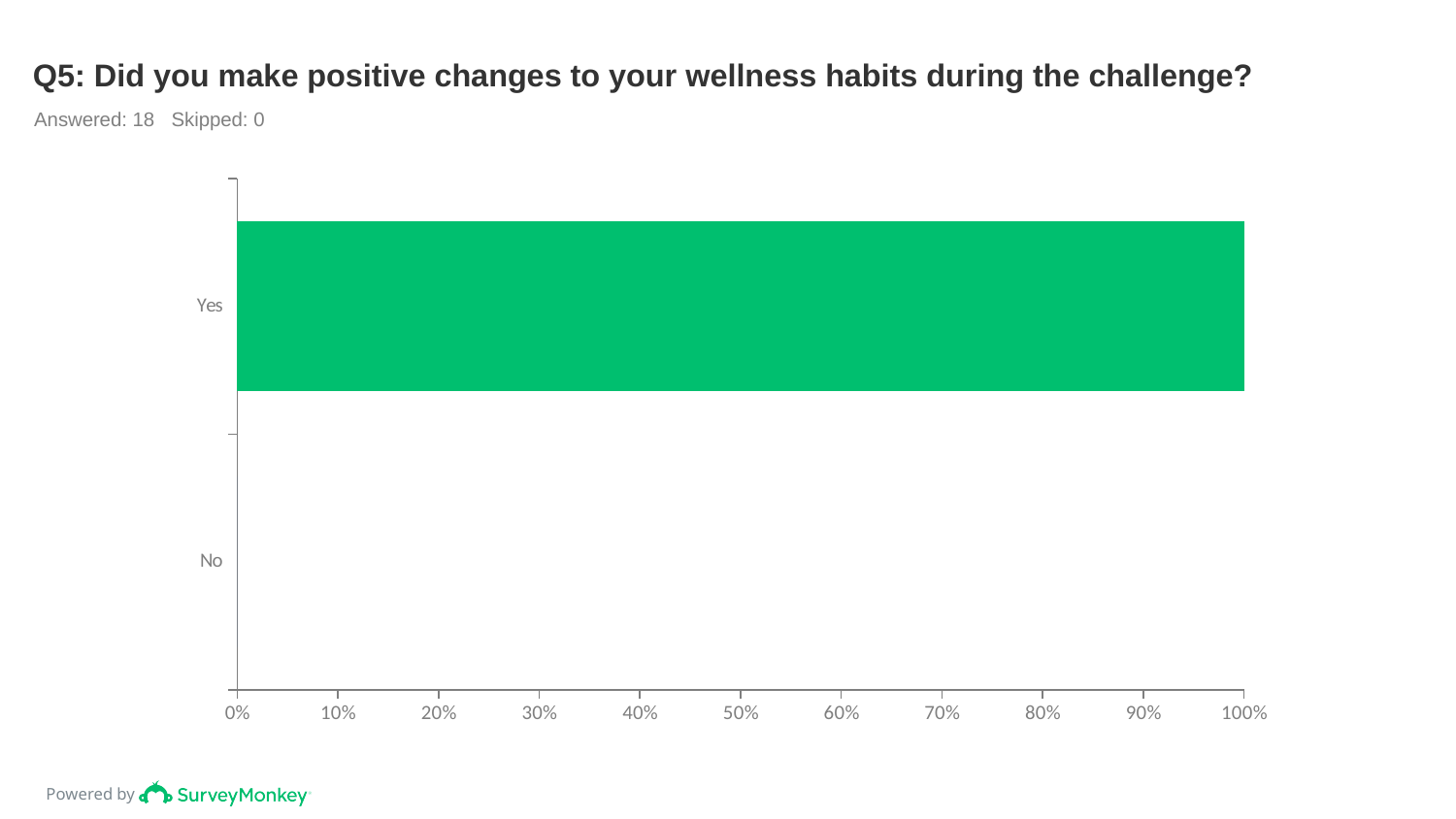
How many respondents answered the question according to the slide? 18 What is the title of the chart? Q5: Did you make positive changes to your wellness habits during the challenge? Is the value for No greater or less than 10%? less What kind of chart is shown on the slide? bar chart Is the value for Yes greater or less than 50%? greater What is the value for Yes? 100% Which category has the highest value? Yes Which category has the lowest value? No What is the value for No? 0% Which is larger, the value for Yes or the value for No? Yes What is the difference between the value for Yes and the value for No? 100% How many categories are shown on the chart? 2